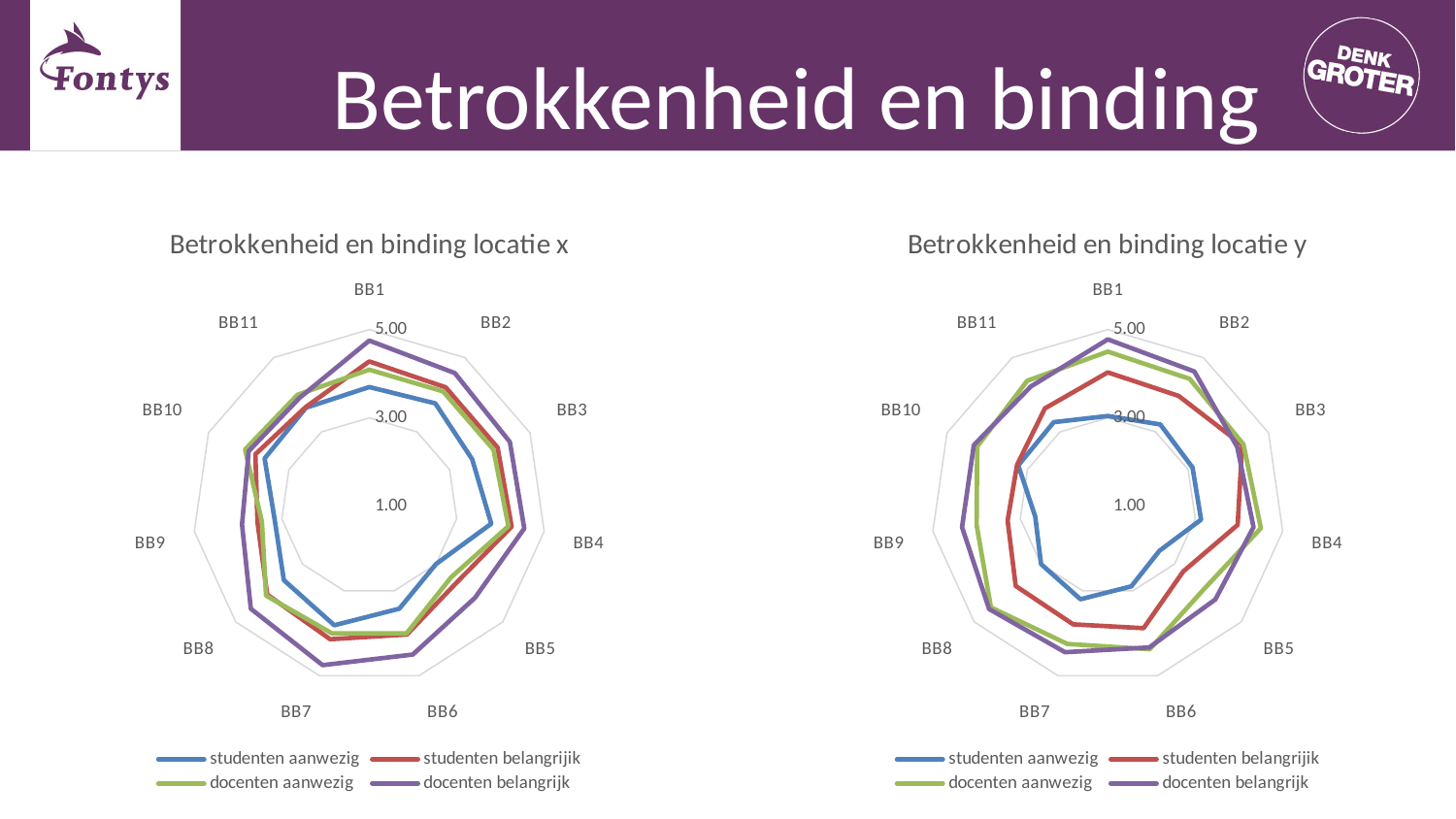
How many categories are plotted in the chart 'Betrokkenheid en binding locatie y'? 11 What is the title of the chart on the right side of the slide? Betrokkenheid en binding locatie y In the chart 'Betrokkenheid en binding locatie y', which series has the lowest value at BB9? studenten aanwezig How many series does the legend of 'Betrokkenheid en binding locatie x' list? 4 In the chart 'Betrokkenheid en binding locatie x', is the value of 'studenten aanwezig' at BB1 greater or less than 3.00? greater What kind of chart is 'Betrokkenheid en binding locatie x'? radar chart In the chart 'Betrokkenheid en binding locatie y', which is larger at BB4: 'docenten aanwezig' or 'studenten aanwezig'? docenten aanwezig In the chart 'Betrokkenheid en binding locatie x', which is larger at BB1: 'docenten belangrijk' or 'studenten aanwezig'? docenten belangrijk In the chart 'Betrokkenheid en binding locatie x', which series has the highest value at BB7? docenten belangrijk In the chart 'Betrokkenheid en binding locatie x', is the value of 'docenten belangrijk' at BB7 greater or less than 3.00? greater In the chart 'Betrokkenheid en binding locatie y', is the value of 'studenten aanwezig' at BB9 greater or less than 3.00? less In the chart 'Betrokkenheid en binding locatie x', which series is drawn in blue? studenten aanwezig